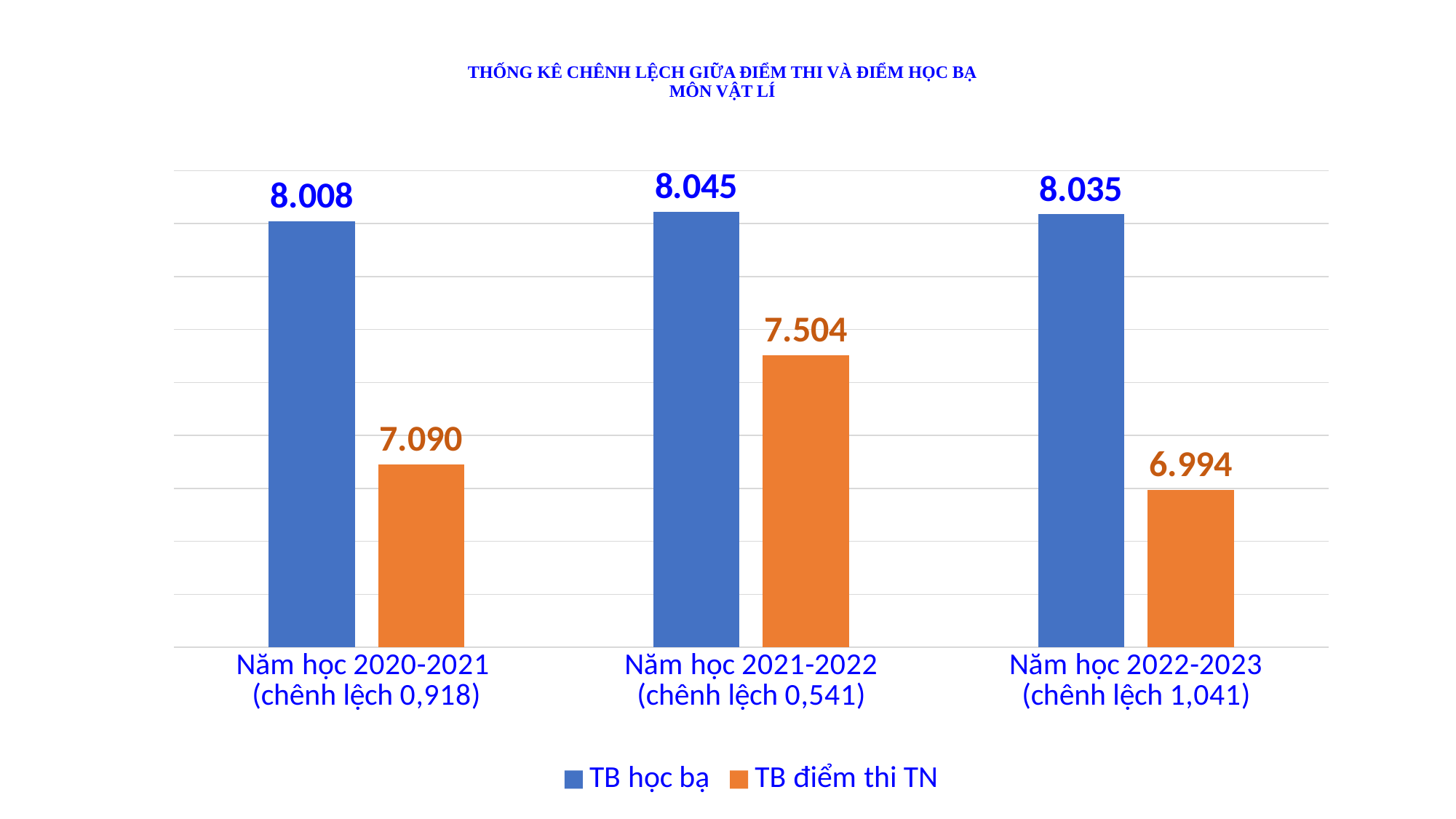
What is the difference between TB học bạ and TB điểm thi TN for Năm học 2020-2021? 0.918 Which school year has the highest TB học bạ value? Năm học 2021-2022 Which school year has the lowest TB điểm thi TN value? Năm học 2022-2023 What is the TB điểm thi TN value for Năm học 2021-2022? 7.504 Which school year has the highest TB điểm thi TN value? Năm học 2021-2022 What is the TB học bạ value for Năm học 2020-2021? 8.008 How many school years are shown on the chart? 3 What is the TB học bạ value for Năm học 2022-2023? 8.035 What is the TB điểm thi TN value for Năm học 2022-2023? 6.994 How many series does the legend list? 2 What kind of chart is shown on the slide? Bar chart Which is larger for Năm học 2022-2023, TB học bạ or TB điểm thi TN? TB học bạ